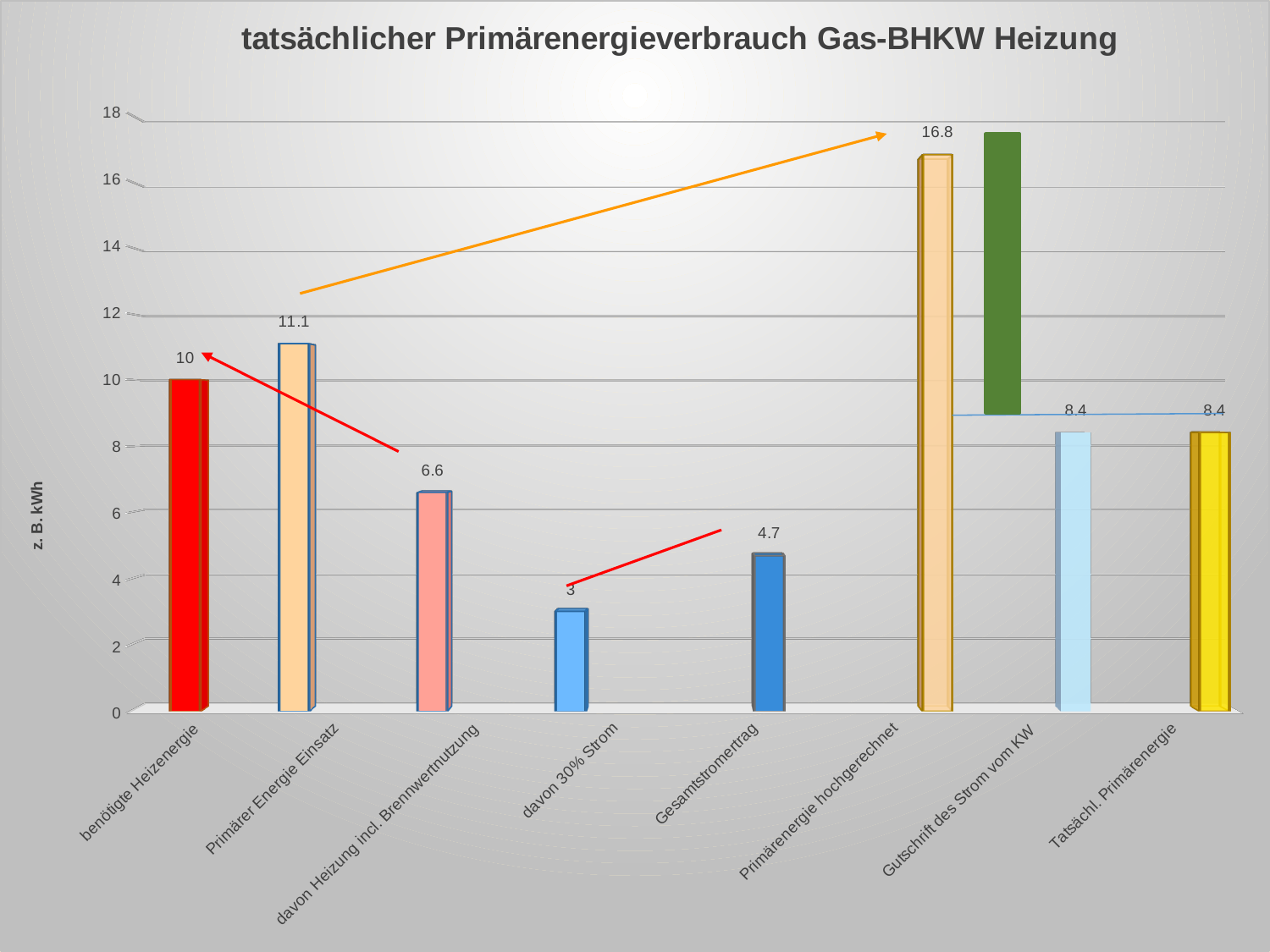
What is the difference between "Primärenergie hochgerechnet" and "Tatsächl. Primärenergie"? 8.4 Which is larger, "Primärer Energie Einsatz" or "benötigte Heizenergie"? Primärer Energie Einsatz What is the value for "Primärenergie hochgerechnet"? 16.8 Which category has the lowest value? davon 30% Strom What kind of chart is shown on the slide? bar chart How many categories are shown on the x axis? 8 Which category has the highest value? Primärenergie hochgerechnet What is the value for "Primärer Energie Einsatz"? 11.1 What is the value for "davon Heizung incl. Brennwertnutzung"? 6.6 What is the title of the chart? tatsächlicher Primärenergieverbrauch Gas-BHKW Heizung What is the value for "Gesamtstromertrag"? 4.7 What is the value for "benötigte Heizenergie"? 10